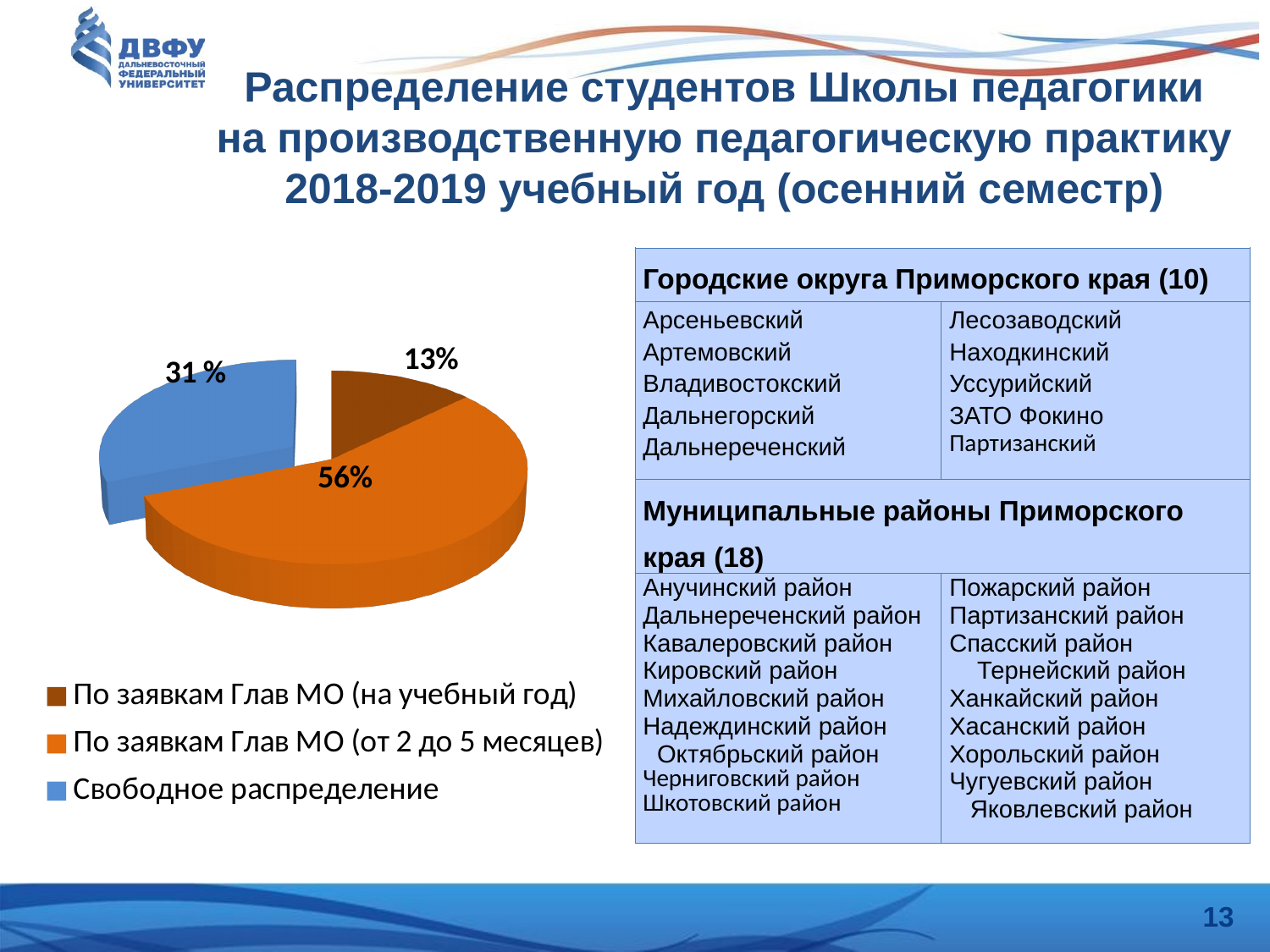
Which is larger: the slice for "Свободное распределение" or the slice for "По заявкам Глав МО (на учебный год)"? Свободное распределение Which category has the smallest slice of the pie? По заявкам Глав МО (на учебный год) How many entries does the legend of the pie chart list? 3 Which category has the largest slice of the pie? По заявкам Глав МО (от 2 до 5 месяцев) What share of the pie is labelled for "По заявкам Глав МО (на учебный год)"? 13% How many slices does the pie chart have? 3 What colour is the slice for "Свободное распределение" in the pie chart? blue What kind of chart is shown on the slide? pie chart What share of the pie is labelled for "Свободное распределение"? 31 % What colour is the slice for "По заявкам Глав МО (от 2 до 5 месяцев)" in the pie chart? orange What share of the pie is labelled for "По заявкам Глав МО (от 2 до 5 месяцев)"? 56% What is the difference in percentage points between the slice for "По заявкам Глав МО (от 2 до 5 месяцев)" and the slice for "Свободное распределение"? 25